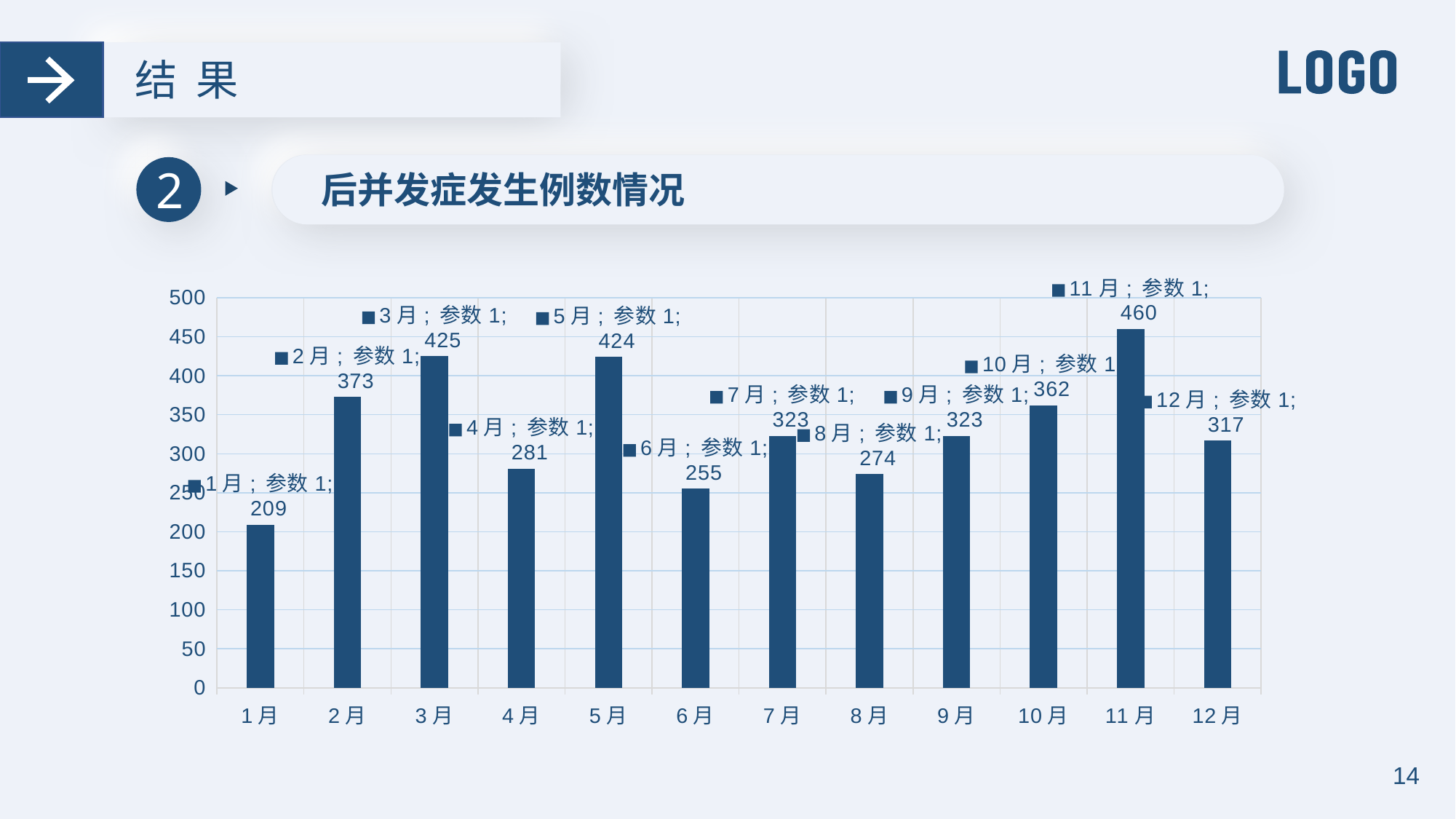
How many months are shown on the x axis? 12 Which month has the lowest value? 1月 What is the difference between the values for 3月 and 4月? 144 Which is larger, the value for 2月 or the value for 10月? 2月 Which month has the highest value? 11月 What kind of chart is shown on the slide? bar chart What is the value for 11月? 460 Do the values rise or fall from 9月 to 11月? rise What is the value for 6月? 255 Is the value for 8月 greater or less than 300? less What is the value for 1月? 209 What is the name of the data series shown in the data labels? 参数 1